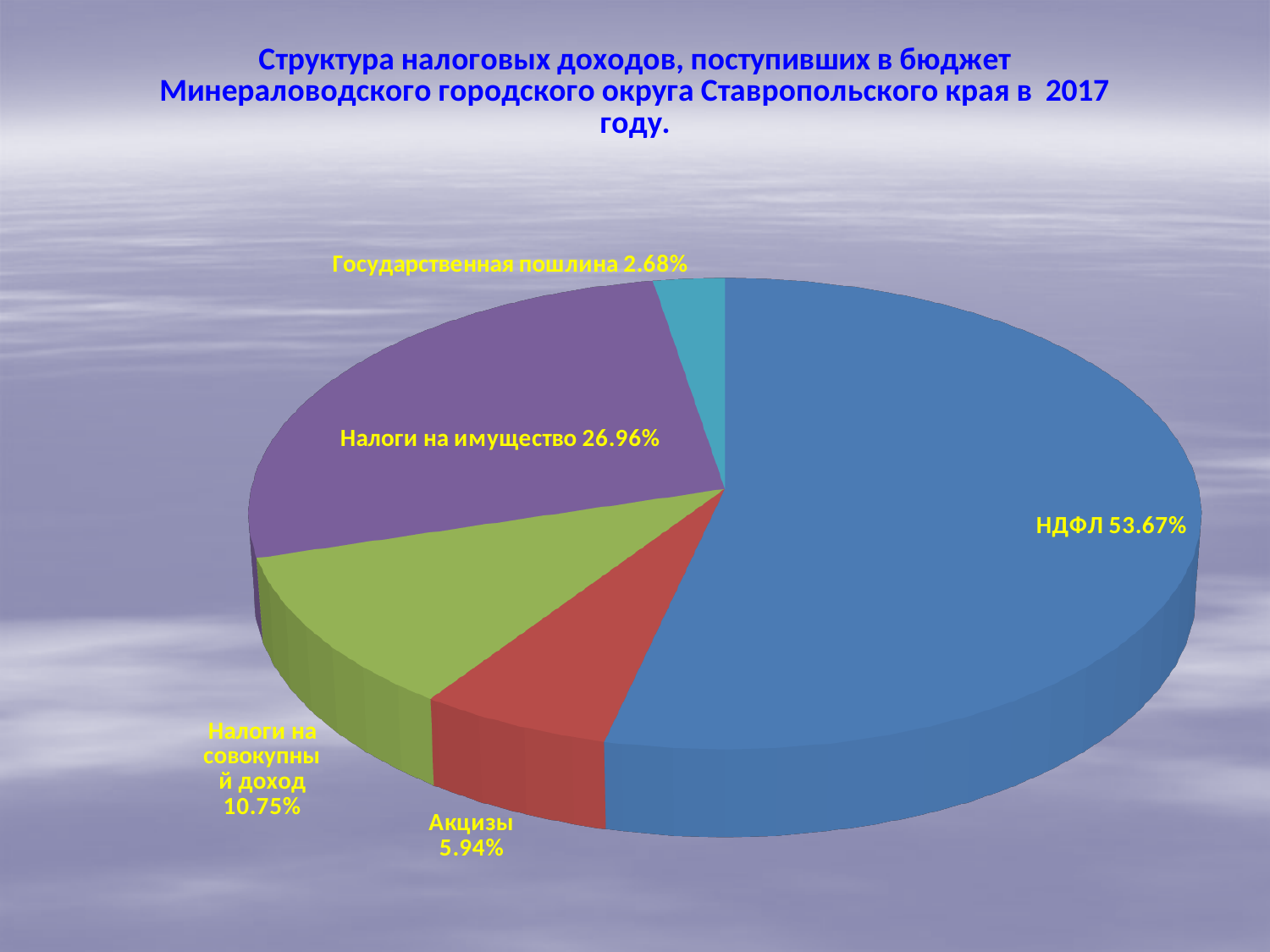
What share of tax revenues does Государственная пошлина account for? 2.68% What share of tax revenues does Налоги на имущество account for? 26.96% What share of tax revenues does НДФЛ account for? 53.67% What share of tax revenues does Акцизы account for? 5.94% Which is larger: the share of Акцизы or the share of Налоги на совокупный доход? Налоги на совокупный доход Which category has the smallest share of tax revenues? Государственная пошлина What colour is the slice for Налоги на имущество? Purple How many categories are shown in the pie chart? 5 What is the difference in percentage points between НДФЛ and Налоги на имущество? 26.71 Which category has the largest share of tax revenues? НДФЛ What share of tax revenues does Налоги на совокупный доход account for? 10.75% What kind of chart is shown on the slide? Pie chart